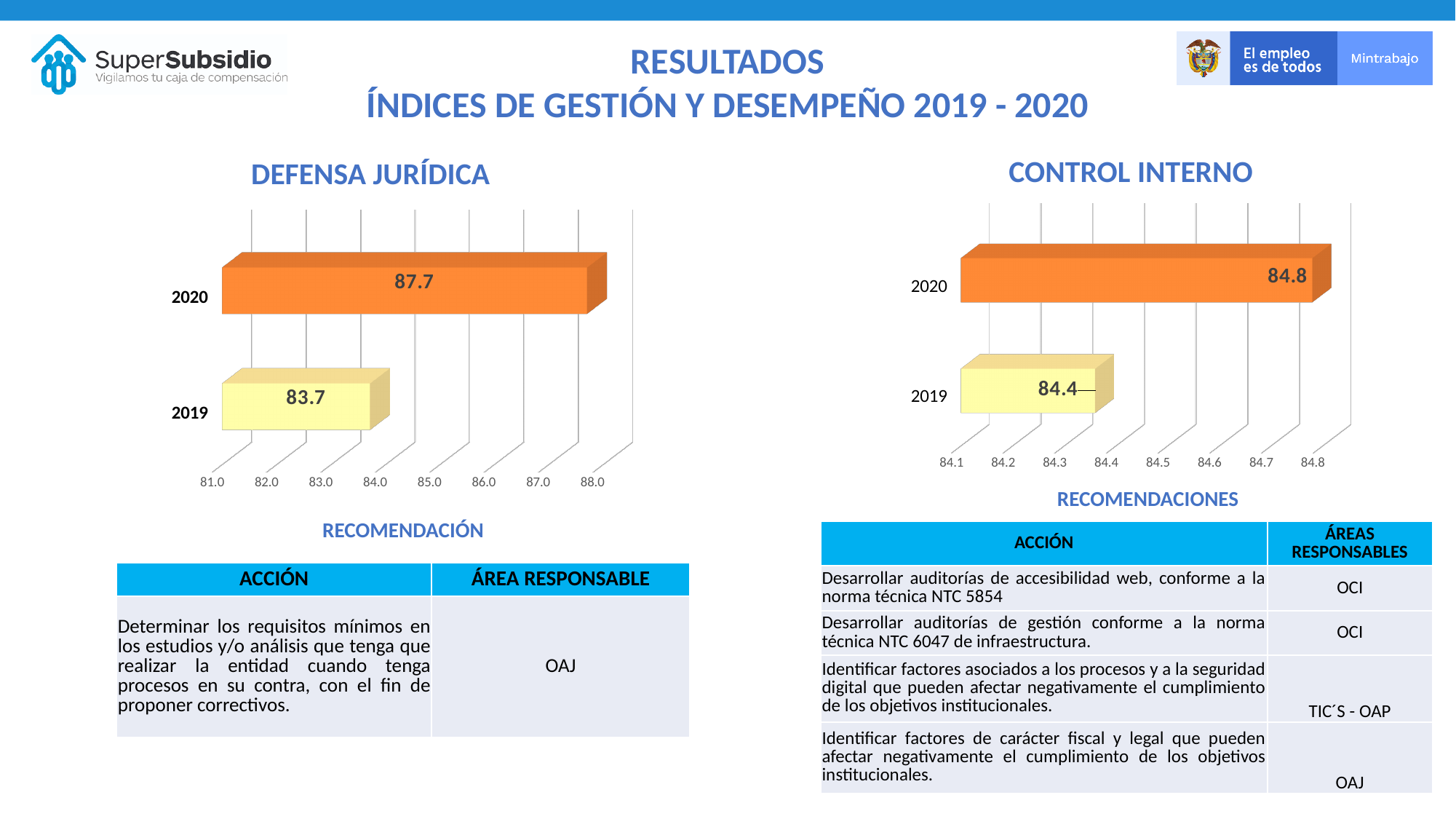
In the DEFENSA JURÍDICA chart, which year has the higher value? 2020 In the DEFENSA JURÍDICA chart, what is the value for 2019? 83.7 In the CONTROL INTERNO chart, what is the value for 2020? 84.8 In the DEFENSA JURÍDICA chart, what is the difference between the 2020 and 2019 values? 4.0 In the DEFENSA JURÍDICA chart, is the value for 2019 greater or less than 85.0? less In the CONTROL INTERNO chart, which year has the lower value? 2019 In the CONTROL INTERNO chart, what colour is the bar for 2020? Orange In the DEFENSA JURÍDICA chart, what is the value for 2020? 87.7 In the CONTROL INTERNO chart, what is the value for 2019? 84.4 In the CONTROL INTERNO chart, what is the difference between the 2020 and 2019 values? 0.4 What kind of chart is the DEFENSA JURÍDICA chart? Bar chart How many bars are shown in the CONTROL INTERNO chart? 2